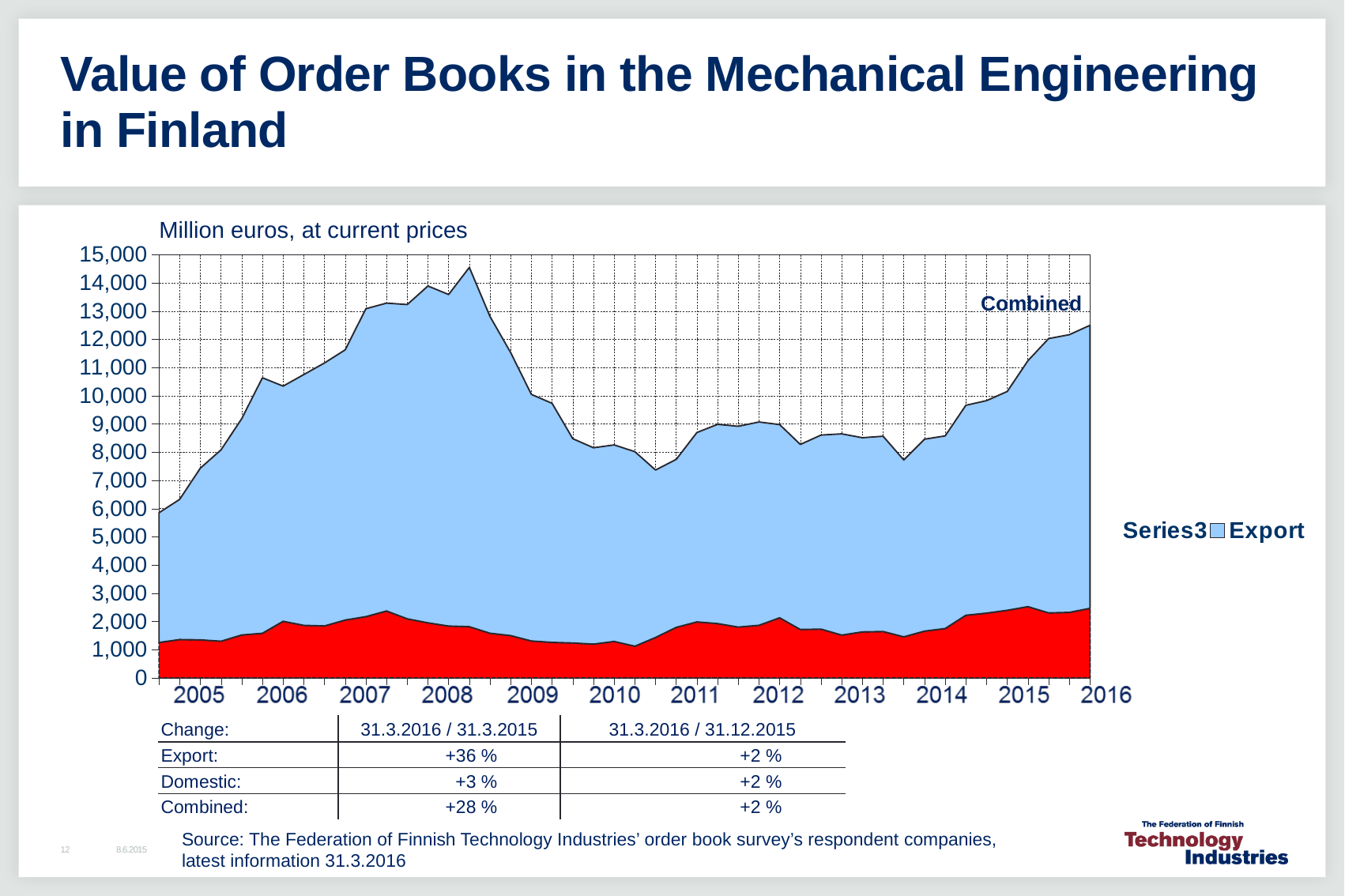
Which series is shown in light blue in the legend? Export Is the peak Combined value in 2008 greater or less than 14,000? greater How many year labels appear on the x axis? 12 What unit is stated above the chart's y axis? Million euros, at current prices Is the Combined value at the start of 2005 greater or less than 7,000? less Does the red Series3 area ever exceed 3,000 on the y axis? No Does the Combined value rise or fall between 2014 and 2016? Rise Does the Combined value rise or fall between 2008 and 2010? Fall How many series does the chart legend list? 2 In which year does the Combined value reach its highest point? 2008 What kind of chart is shown on the slide? Area chart